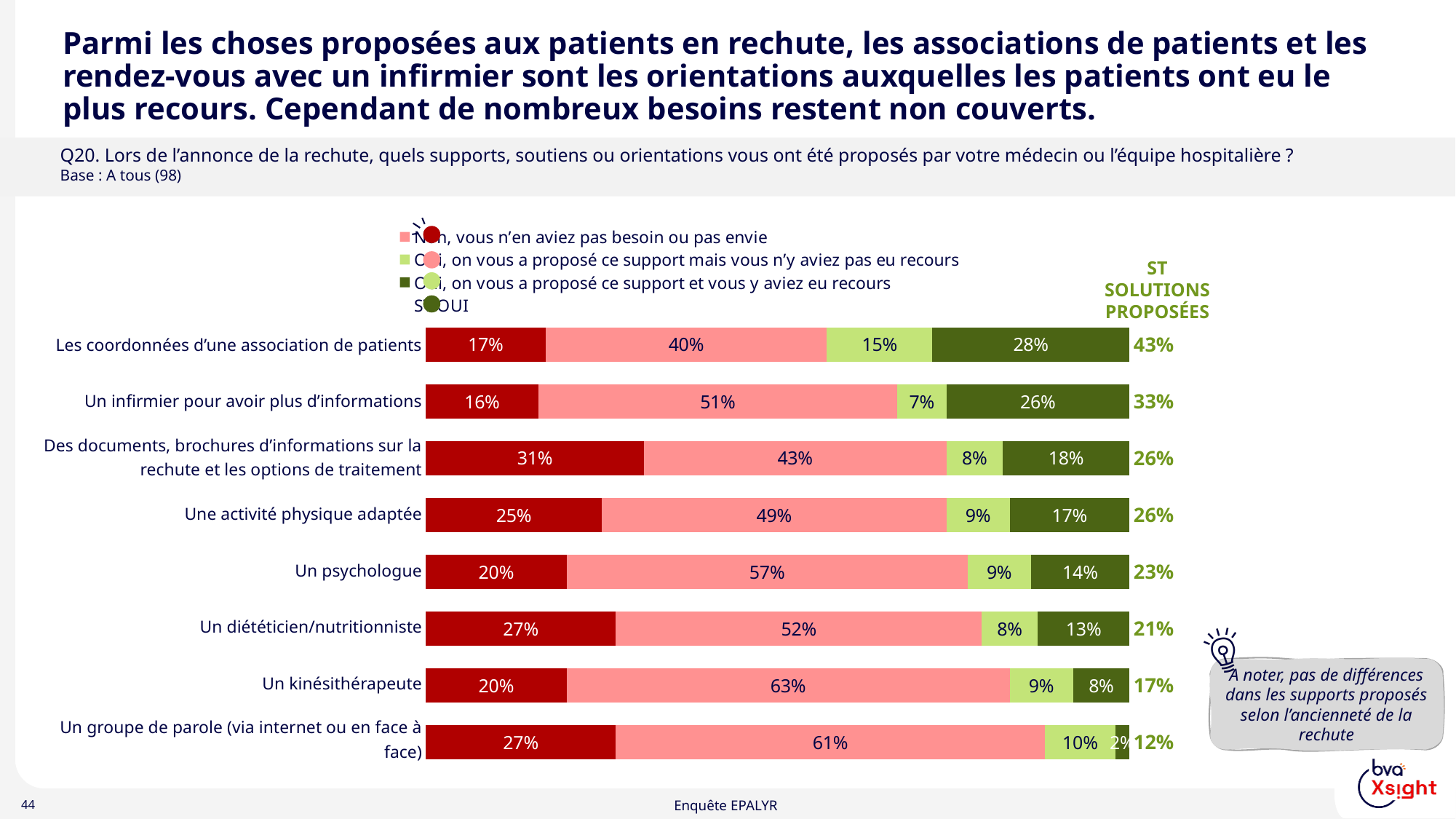
How many categories (bars) are shown in the chart? 8 Which category has the lowest "ST SOLUTIONS PROPOSÉES" value? Un groupe de parole (via internet ou en face à face) What is the "ST SOLUTIONS PROPOSÉES" value for "Un psychologue"? 23% What is the value of the dark green segment for "Les coordonnées d'une association de patients"? 28% What is the total of the four segments for "Un infirmier pour avoir plus d'informations"? 100% What is the difference in "ST SOLUTIONS PROPOSÉES" between "Les coordonnées d'une association de patients" and "Un infirmier pour avoir plus d'informations"? 10 points What is the base (number of respondents) stated for this question? 98 Which category has the highest "ST SOLUTIONS PROPOSÉES" value? Les coordonnées d'une association de patients What kind of chart is shown on the slide? Stacked bar chart What is the value of the dark red segment for "Des documents, brochures d'informations sur la rechute et les options de traitement"? 31% What is the value of the light green segment for "Un groupe de parole (via internet ou en face à face)"? 10% Which has the larger pink segment: "Un kinésithérapeute" or "Un psychologue"? Un kinésithérapeute